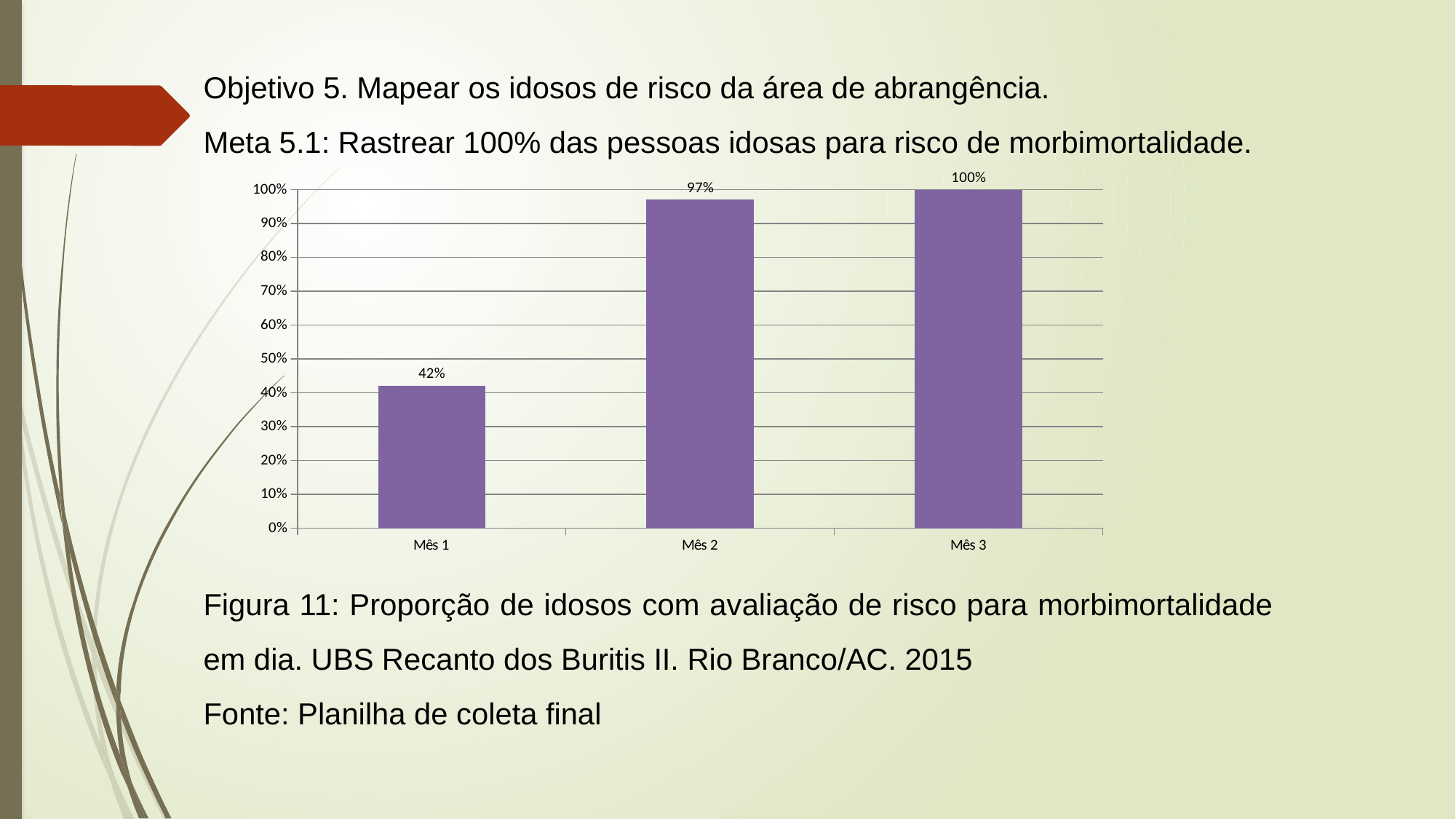
What kind of chart is shown on the slide? bar chart Which is larger, the value for Mês 1 or the value for Mês 2? Mês 2 What is the value for Mês 3? 100% Which month has the lowest value? Mês 1 Is the value for Mês 1 greater or less than 50%? less Which month has the highest value? Mês 3 What is the value for Mês 2? 97% Do the values rise or fall from Mês 1 to Mês 3? rise What is the value for Mês 1? 42% How many months are shown on the chart? 3 What is the difference between the values for Mês 3 and Mês 2? 3% What is the difference between the values for Mês 2 and Mês 1? 55%